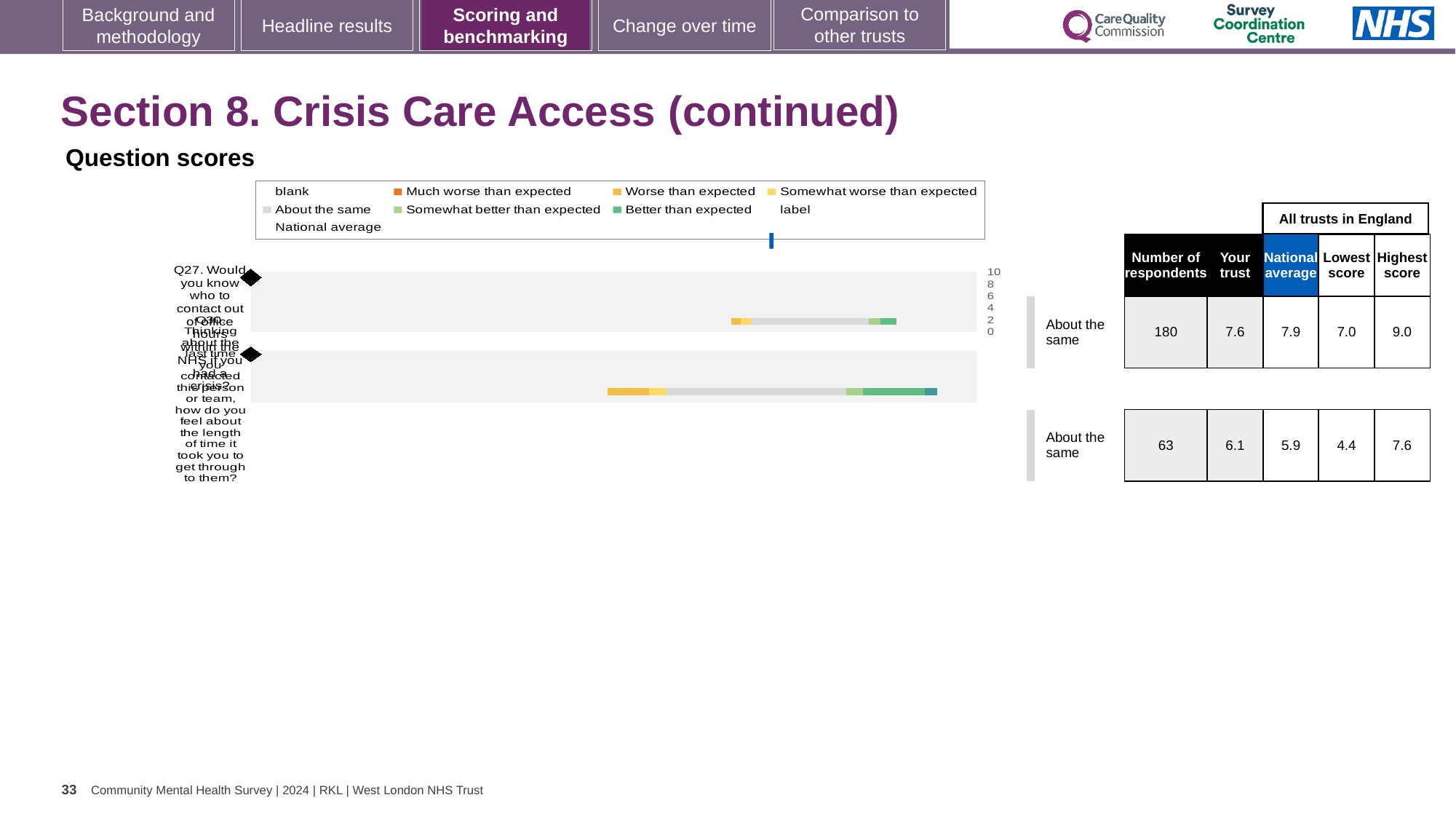
What is the difference between the highest and lowest scores for Q27? 2.0 What kind of chart is shown under 'Question scores'? bar chart What is the national average score for Q30? 5.9 What is the 'Your trust' score for Q27? 7.6 What is the difference between the highest and lowest scores for Q30? 3.2 What is the highest score among all trusts in England for Q30? 7.6 For Q30, which is higher: the 'Your trust' score or the national average? Your trust For Q27, which is higher: the 'Your trust' score or the national average? National average How many respondents answered Q27? 180 What is the lowest score among all trusts in England for Q27? 7.0 How many questions are plotted in the chart? 2 What benchmark category is shown for Q30? About the same